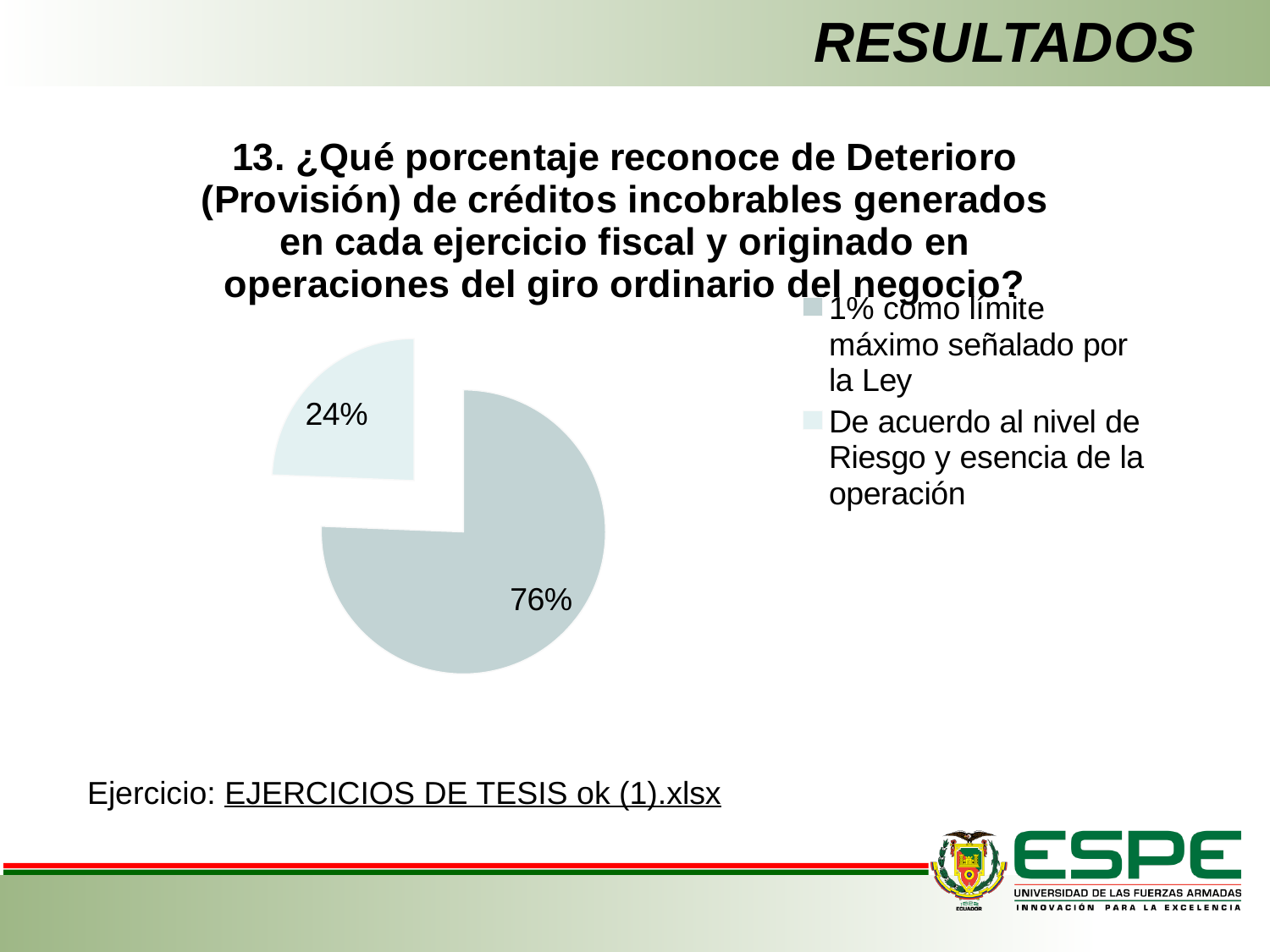
Which response has the largest slice of the pie? 1% como límite máximo señalado por la Ley How many entries does the legend list? 2 What share of the pie corresponds to "De acuerdo al nivel de Riesgo y esencia de la operación"? 24% What share of the pie corresponds to "1% como límite máximo señalado por la Ley"? 76% Which response has the smallest slice of the pie? De acuerdo al nivel de Riesgo y esencia de la operación What is the number of the survey question shown as the chart title? 13 Which slice of the pie is pulled out (exploded) from the rest? 24% Which is larger: the slice for "1% como límite máximo señalado por la Ley" or the slice for "De acuerdo al nivel de Riesgo y esencia de la operación"? 1% como límite máximo señalado por la Ley What kind of chart is shown on the slide? pie chart How many slices does the pie chart have? 2 What is the difference in percentage points between the two slices of the pie? 52